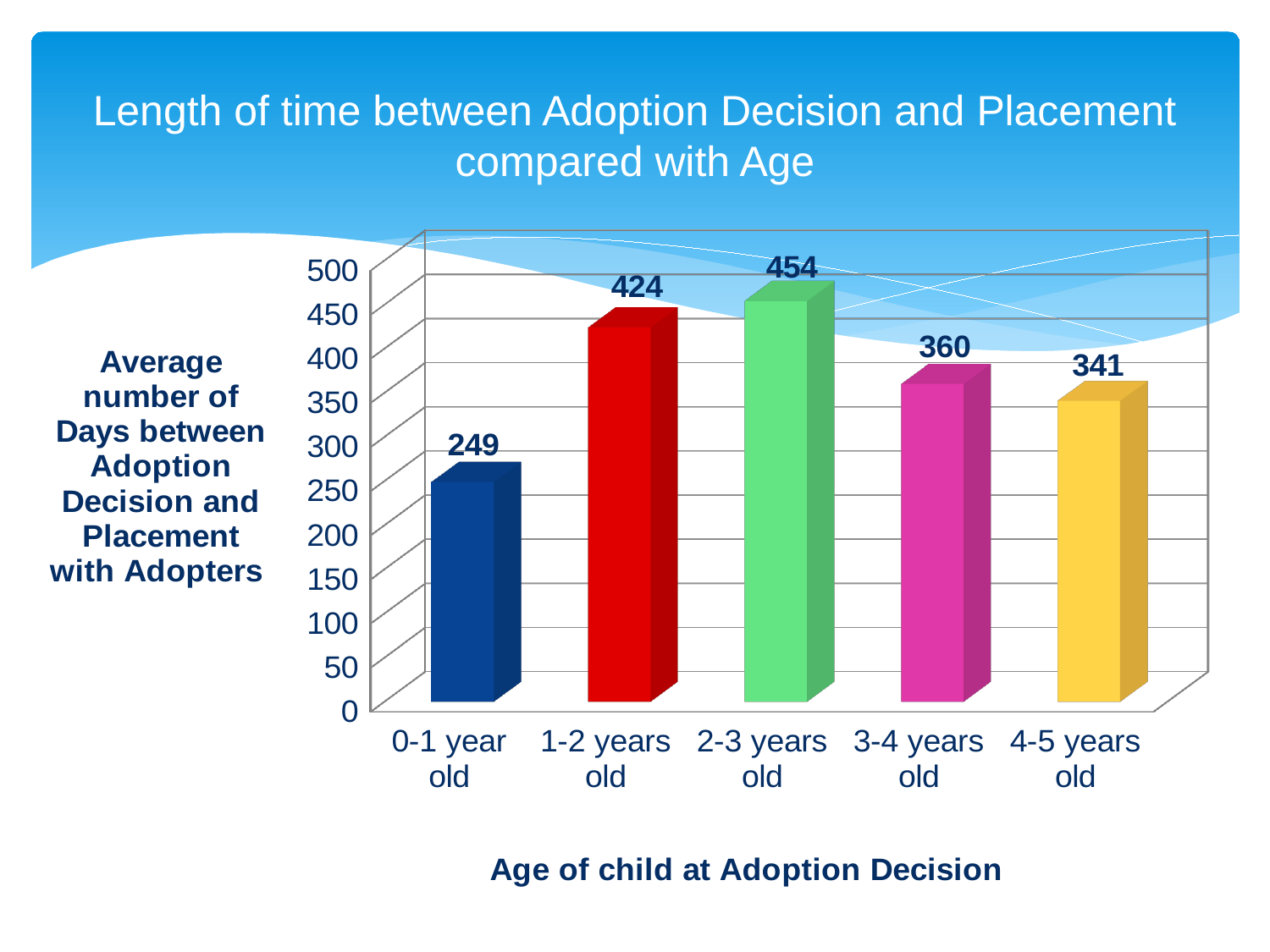
What is the average number of days between adoption decision and placement for children 0-1 year old? 249 Which age group has the lowest average number of days between adoption decision and placement? 0-1 year old What is the label of the x axis? Age of child at Adoption Decision Is the value for 1-2 years old greater or less than 400? greater How many age categories are shown on the x axis? 5 What is the value shown for the 4-5 years old category? 341 Which age group has the highest average number of days between adoption decision and placement? 2-3 years old Which has a larger value, 3-4 years old or 4-5 years old? 3-4 years old What is the value shown for the 2-3 years old category? 454 What kind of chart is shown on the slide? bar chart What is the difference in days between the 2-3 years old and 0-1 year old categories? 205 What is the difference between the values for 1-2 years old and 3-4 years old? 64